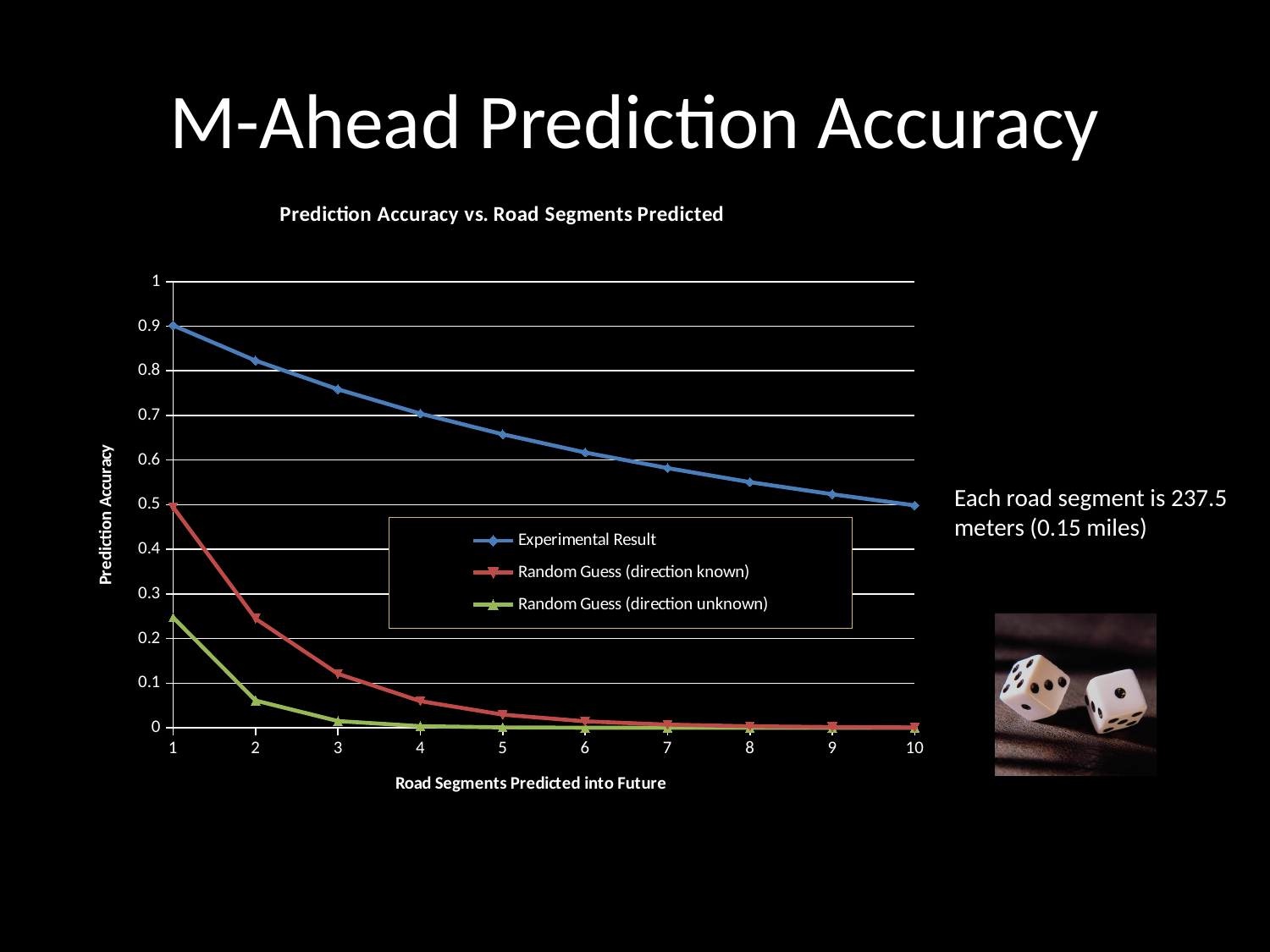
At 2 road segments, which is larger: Experimental Result or Random Guess (direction known)? Experimental Result What is the title of the chart? Prediction Accuracy vs. Road Segments Predicted How many series does the legend list? 3 What kind of chart is shown on the slide? line chart Is the Random Guess (direction unknown) value at 1 road segment greater or less than 0.2? greater Is the Random Guess (direction known) value at 3 road segments greater or less than 0.2? less Is the Experimental Result value at 5 road segments greater or less than 0.6? greater How many road segment values are plotted along the x axis? 10 Does the Experimental Result series rise or fall as the number of road segments predicted increases? fall Which series has the highest prediction accuracy at 10 road segments? Experimental Result